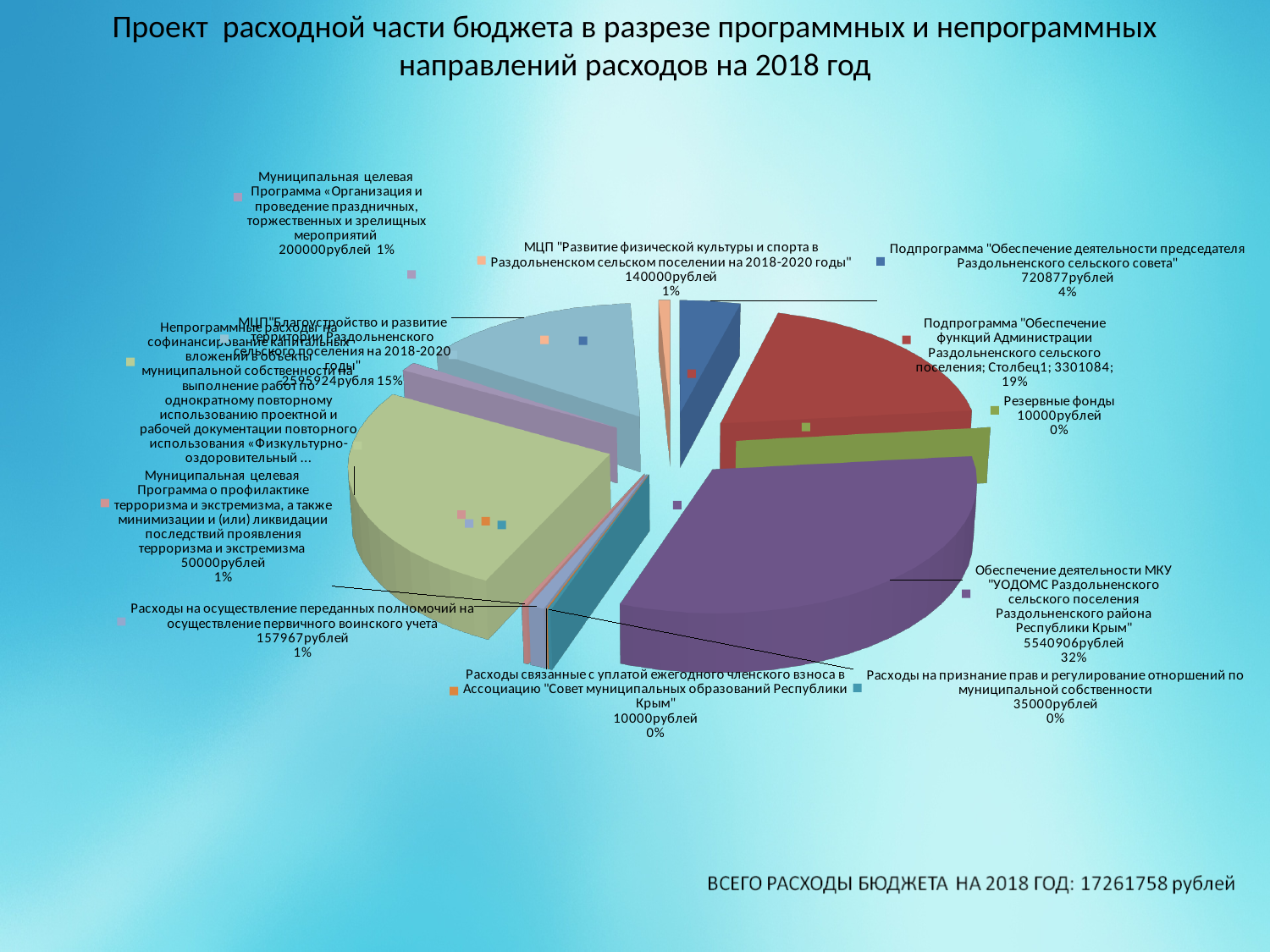
What is the value shown for Обеспечение деятельности МКУ "УОДОМС Раздольненского сельского поселения Раздольненского района Республики Крым"? 5540906рублей What share of the pie does Подпрограмма "Обеспечение функций Администрации Раздольненского сельского поселения" represent? 19% What is the total budget expenditure for 2018 stated on the slide? 17261758 рублей What share of the pie does Расходы на признание прав и регулирование отношений по муниципальной собственности represent? 0% Which is larger: the value for Расходы на осуществление переданных полномочий на осуществление первичного воинского учета or the value for Муниципальная целевая Программа о профилактике терроризма и экстремизма? Расходы на осуществление переданных полномочий на осуществление первичного воинского учета What kind of chart is shown on the slide? pie chart What is the difference between the value for Обеспечение деятельности МКУ "УОДОМС" (5540906) and the value for Подпрограмма "Обеспечение функций Администрации" (3301084)? 2239822 What is the value shown for Резервные фонды? 10000рублей What is the value shown for Подпрограмма "Обеспечение деятельности председателя Раздольненского сельского совета"? 720877рублей What is the value shown for МЦП "Развитие физической культуры и спорта в Раздольненском сельском поселении на 2018-2020 годы"? 140000рублей What share of the pie does Обеспечение деятельности МКУ "УОДОМС Раздольненского сельского поселения" represent? 32% Which category has the largest share of the pie? Обеспечение деятельности МКУ "УОДОМС Раздольненского сельского поселения Раздольненского района Республики Крым"